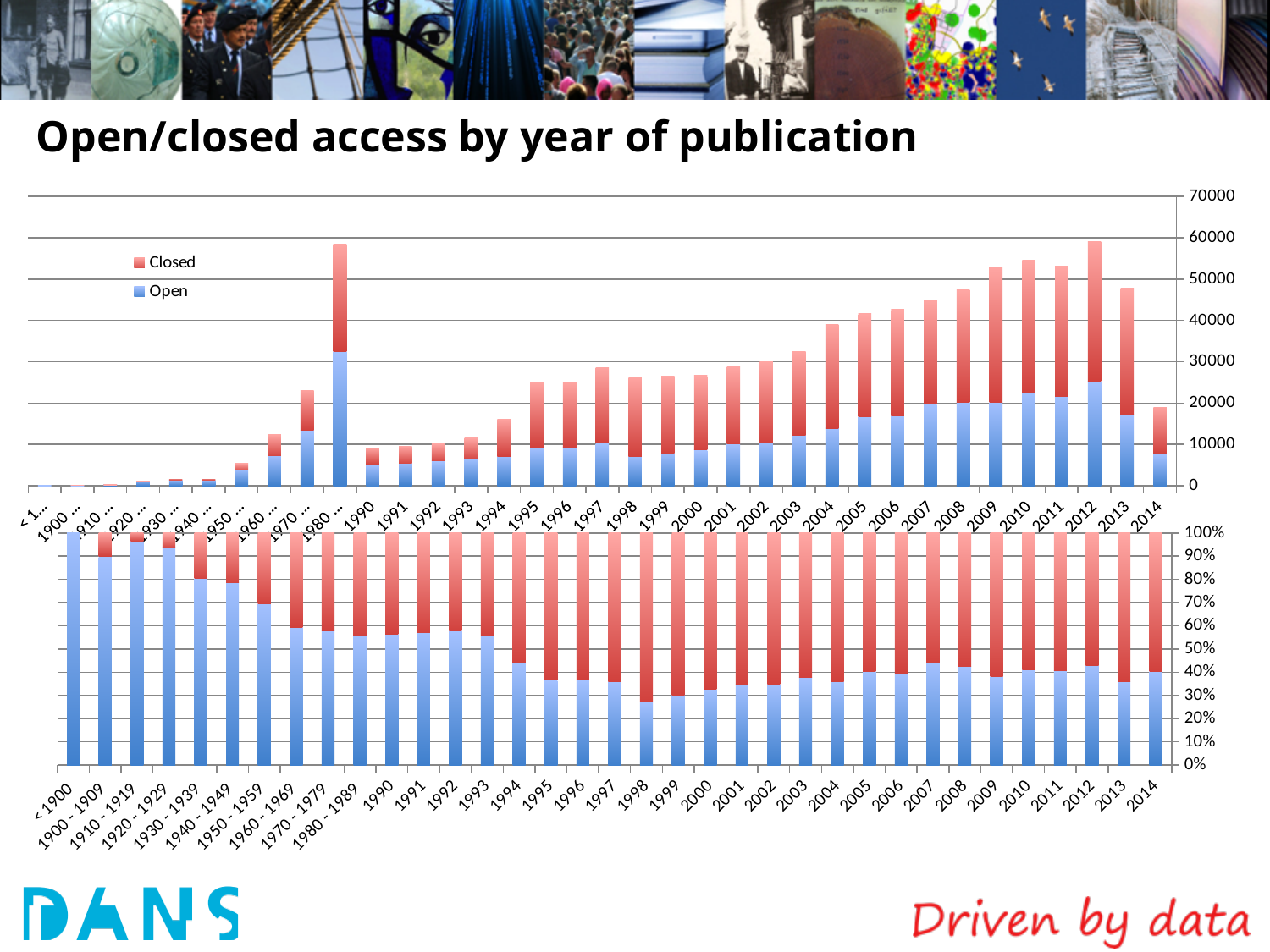
In the bottom chart, does the Open share rise or fall from 1990 to 1998? fall In the top chart, do the total bar heights rise or fall from 2003 to 2010? rise In the top chart, is the total bar height for 1994 greater or less than 20000? less In the top chart, is the total bar height for 2008 greater or less than 40000? greater In the top chart, which has the taller total bar, 2010 or 2014? 2010 What are the two series named in the legend of the top chart? Closed and Open What kind of chart is the top chart on the slide? bar chart How many series does the legend of the top chart list? 2 In the top chart, is the total bar height for 2010 greater or less than 50000? greater How many year categories are shown along the x axis of the bottom chart? 35 In the bottom chart, which year has the lowest Open share? 1998